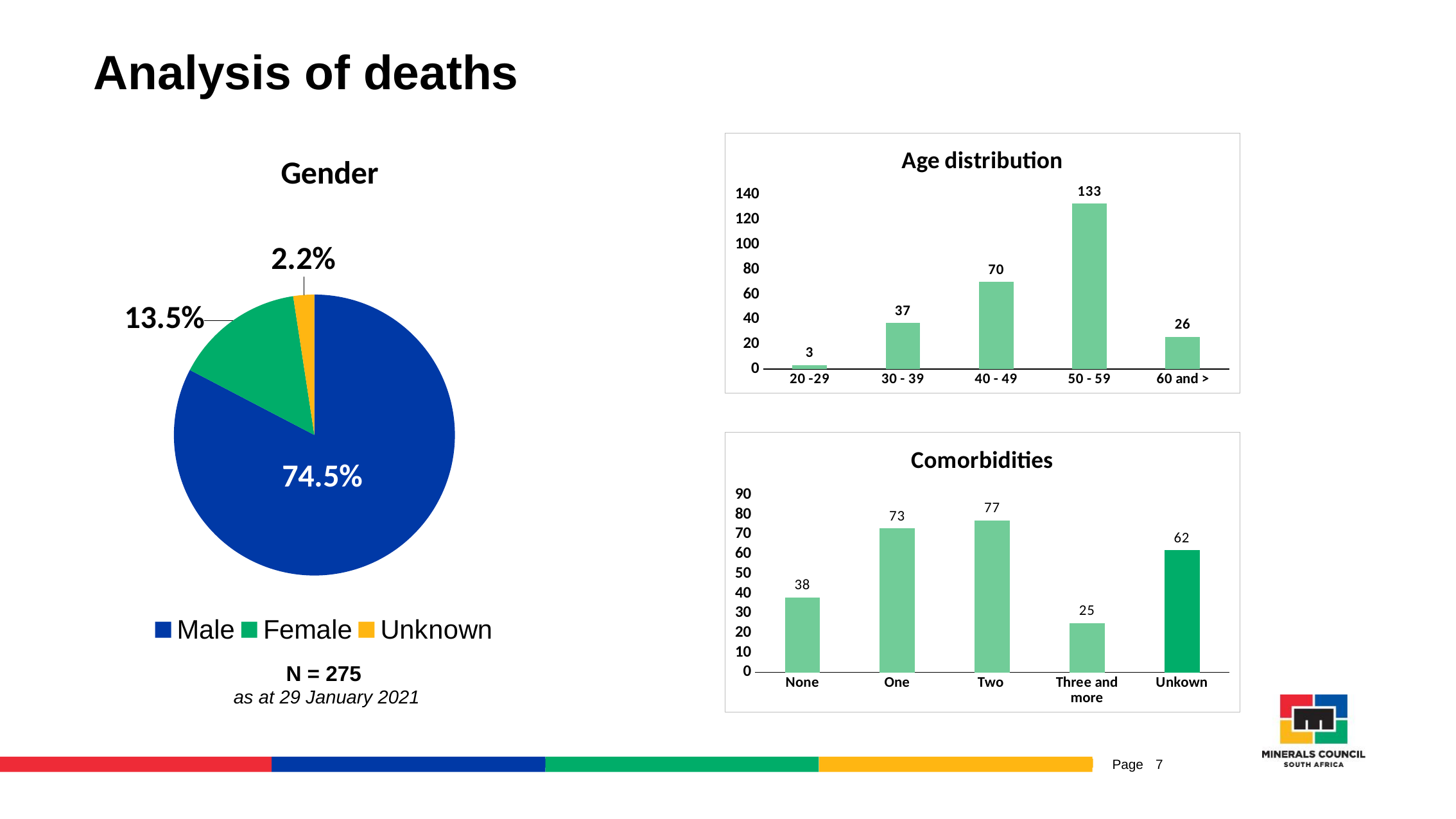
In the Gender pie chart, how many categories does the legend list? 3 What kind of chart is the Comorbidities chart? Bar chart In the Comorbidities chart, which is larger, None or Unkown? Unkown In the Age distribution chart, how many age groups are shown? 5 In the Comorbidities chart, which category has the highest value? Two What kind of chart is the Gender chart? Pie chart In the Age distribution chart, what is the difference between the 50 - 59 and 40 - 49 age groups? 63 In the Gender pie chart, what share of deaths is Male? 74.5% In the Comorbidities chart, what is the value for Two? 77 In the Age distribution chart, what is the value for the 50 - 59 age group? 133 In the Age distribution chart, which age group has the lowest value? 20 -29 In the Gender pie chart, what share of deaths is Female? 13.5%